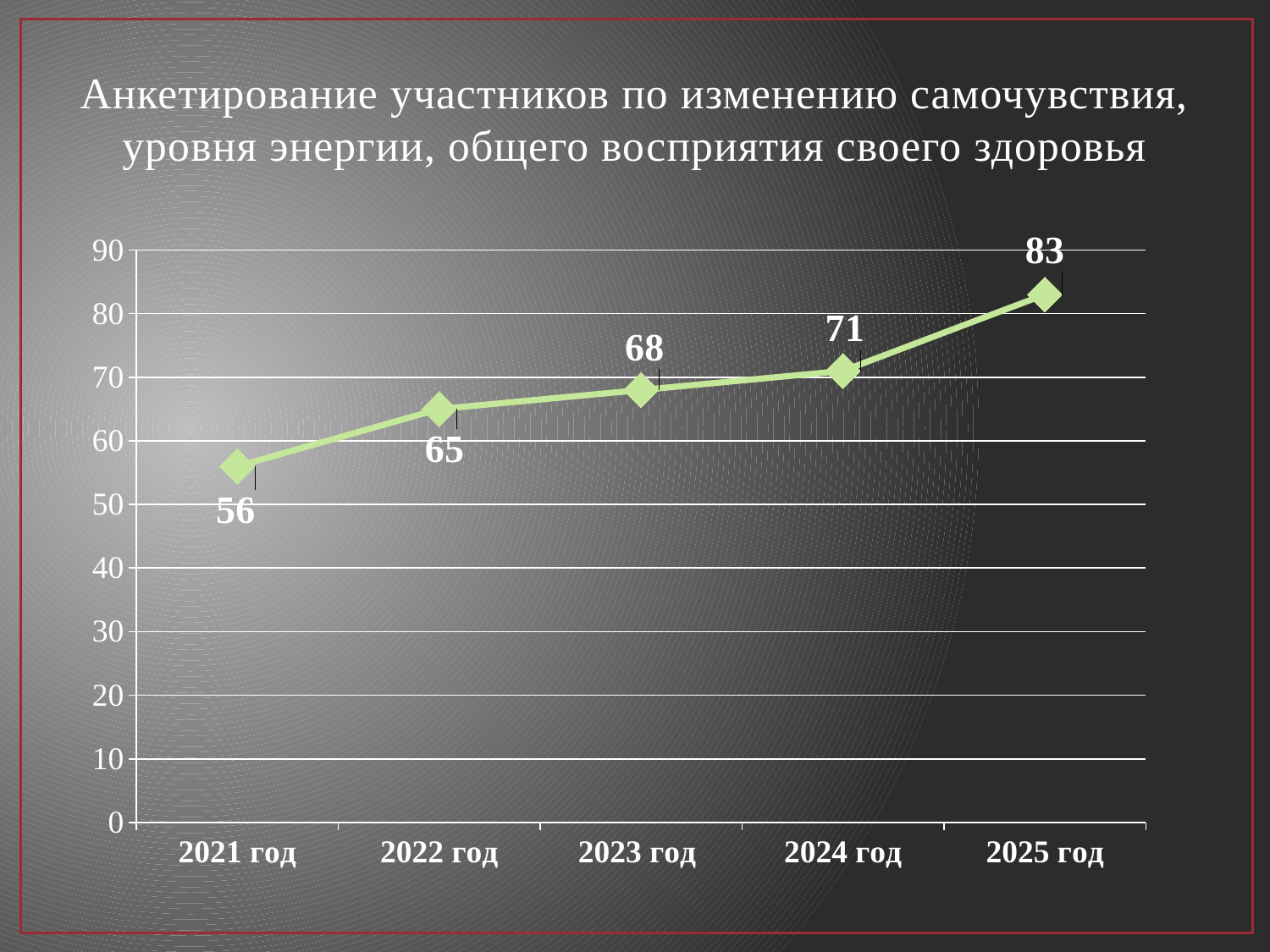
What is the value for 2021 год? 56 What is the value for 2023 год? 68 Is the value for 2022 год greater or less than 60? greater What is the difference between the values for 2025 год and 2021 год? 27 Which year has the lowest value? 2021 год What is the value for 2025 год? 83 Which is larger, the value for 2022 год or the value for 2024 год? 2024 год How many data points are plotted on the chart? 5 Do the values rise or fall from 2021 год to 2025 год? rise What is the difference between the values for 2024 год and 2023 год? 3 Which year has the highest value? 2025 год What kind of chart is shown on the slide? line chart